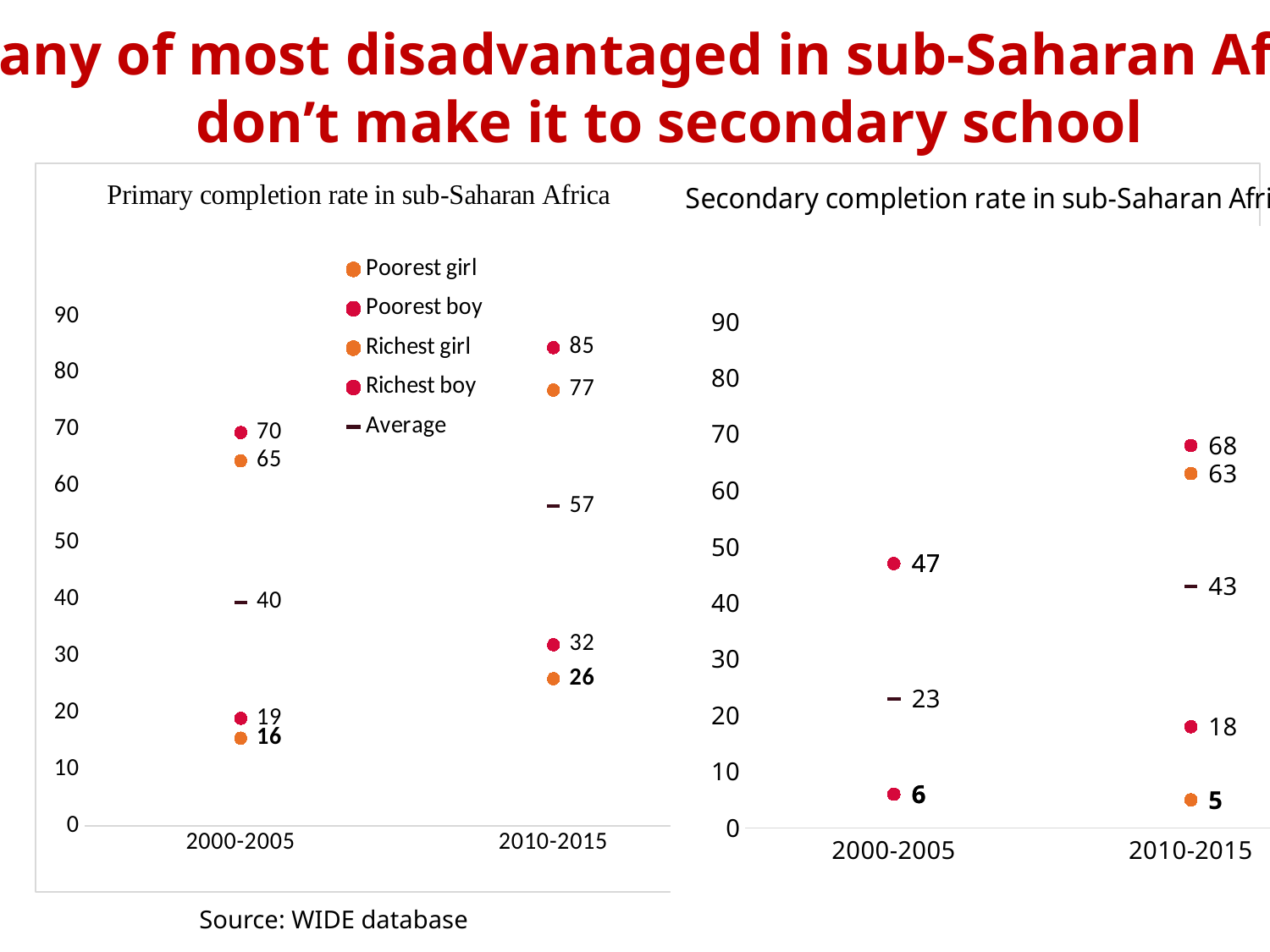
How many time periods are shown on the x axis of the Secondary completion rate chart? 2 On the Secondary completion rate chart, what is the difference between the Average for 2010-2015 and the Average for 2000-2005? 20 On the Secondary completion rate chart, what is the Average value for 2010-2015? 43 How many series does the legend on the Primary completion rate chart list? 5 On the Primary completion rate chart, what is the Average value for 2010-2015? 57 On the Primary completion rate chart, does the Average rise or fall from 2000-2005 to 2010-2015? rise On the Secondary completion rate chart, what is the Average value for 2000-2005? 23 On the Primary completion rate chart, by how much did the Average rise from 2000-2005 to 2010-2015? 17 Which is larger: the Average on the Primary completion rate chart for 2010-2015 or the Average on the Secondary completion rate chart for 2010-2015? Primary (57) On the Secondary completion rate chart, what is the lowest value shown for 2010-2015? 5 On the Primary completion rate chart, what is the Average value for 2000-2005? 40 On the Primary completion rate chart, what is the highest value shown for 2010-2015? 85